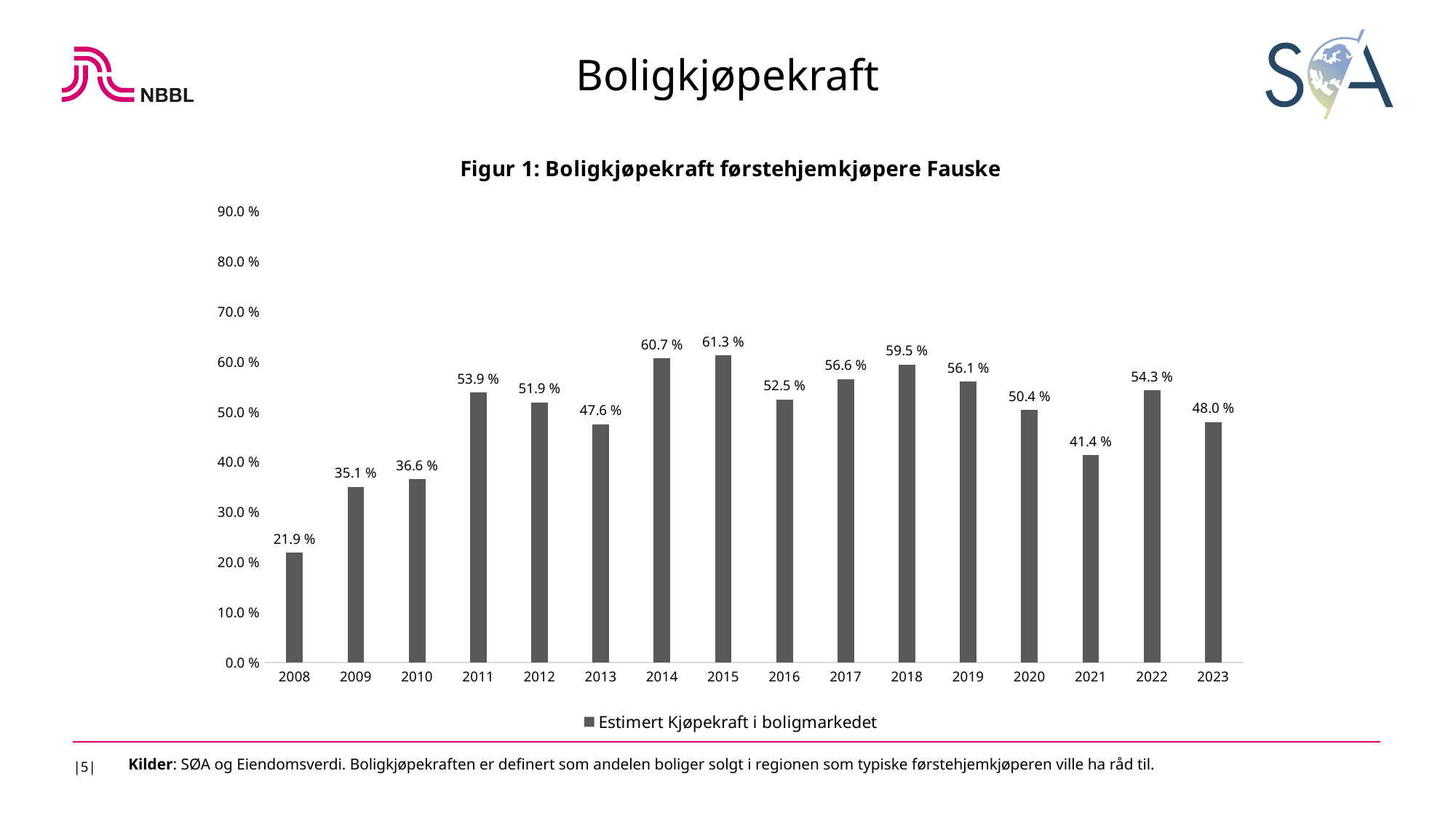
What is the difference between the values for 2015 and 2008? 39.4 % How many series does the legend list? 1 How many years are shown on the x axis? 16 What is the value for 2015? 61.3 % What kind of chart is shown? bar chart What is the value for 2008? 21.9 % Which is larger, the value for 2021 or the value for 2022? 2022 Is the value for 2013 greater or less than 50.0 %? less What is the title of the chart? Figur 1: Boligkjøpekraft førstehjemkjøpere Fauske Which year has the lowest value? 2008 What is the value for 2023? 48.0 % Which year has the highest value? 2015